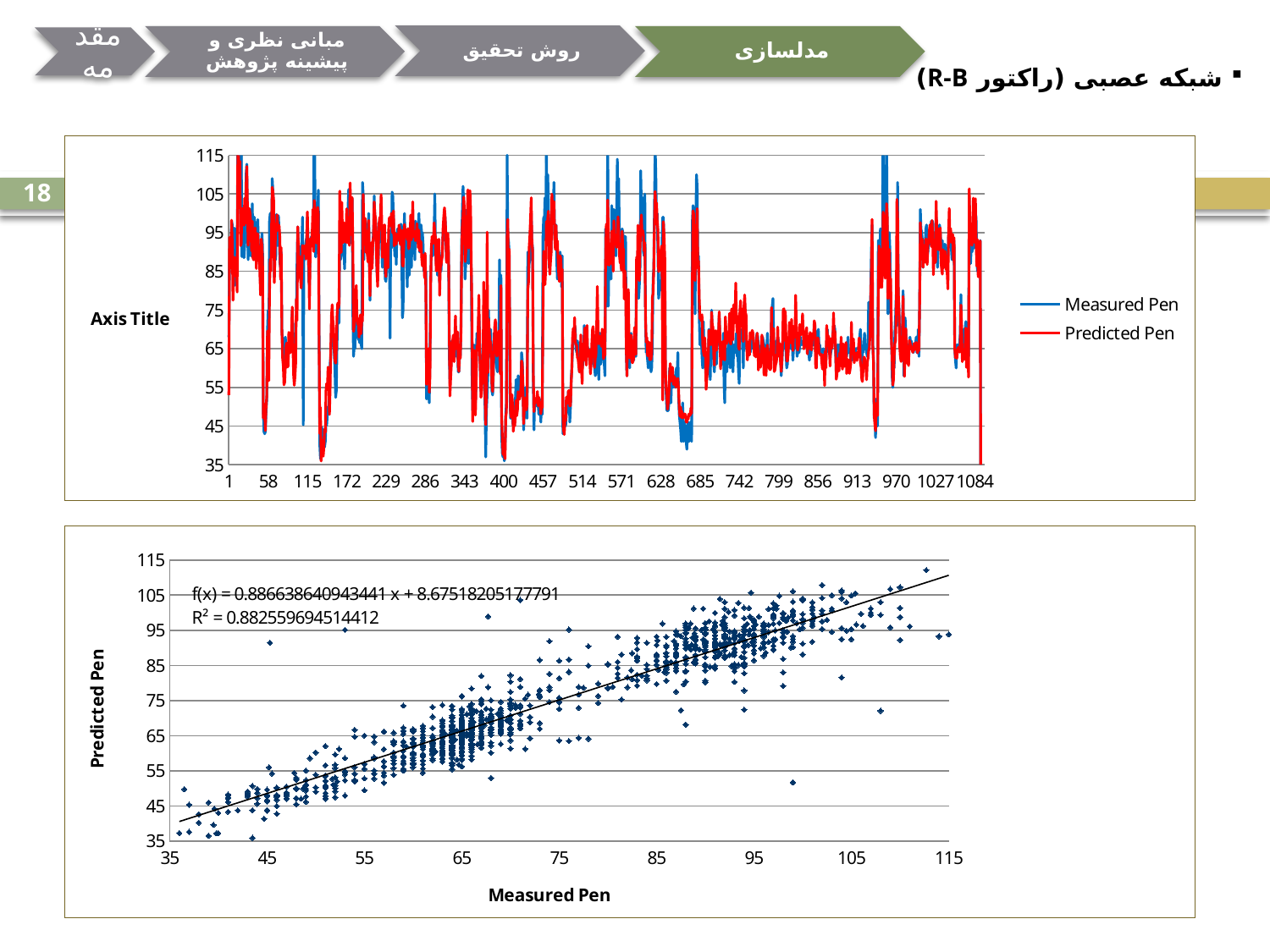
What is the vertical axis title of the top chart? Axis Title What is the slope of the fitted line equation shown on the bottom chart? 0.886638640943441 How many series does the legend of the top chart list? 2 What kind of chart is the bottom chart on the slide? scatter chart What is the intercept of the fitted line equation shown on the bottom chart? 8.67518205177791 What is the R² value shown on the bottom chart? 0.882559694514412 In the top chart, which series is drawn in red? Predicted Pen What is the horizontal axis title of the bottom chart? Measured Pen What kind of chart is the top chart on the slide? line chart What is the last tick label on the horizontal axis of the top chart? 1084 What is the highest tick value on the vertical axis of the top chart? 115 In the bottom chart, do the Predicted Pen values rise or fall as Measured Pen increases? rise